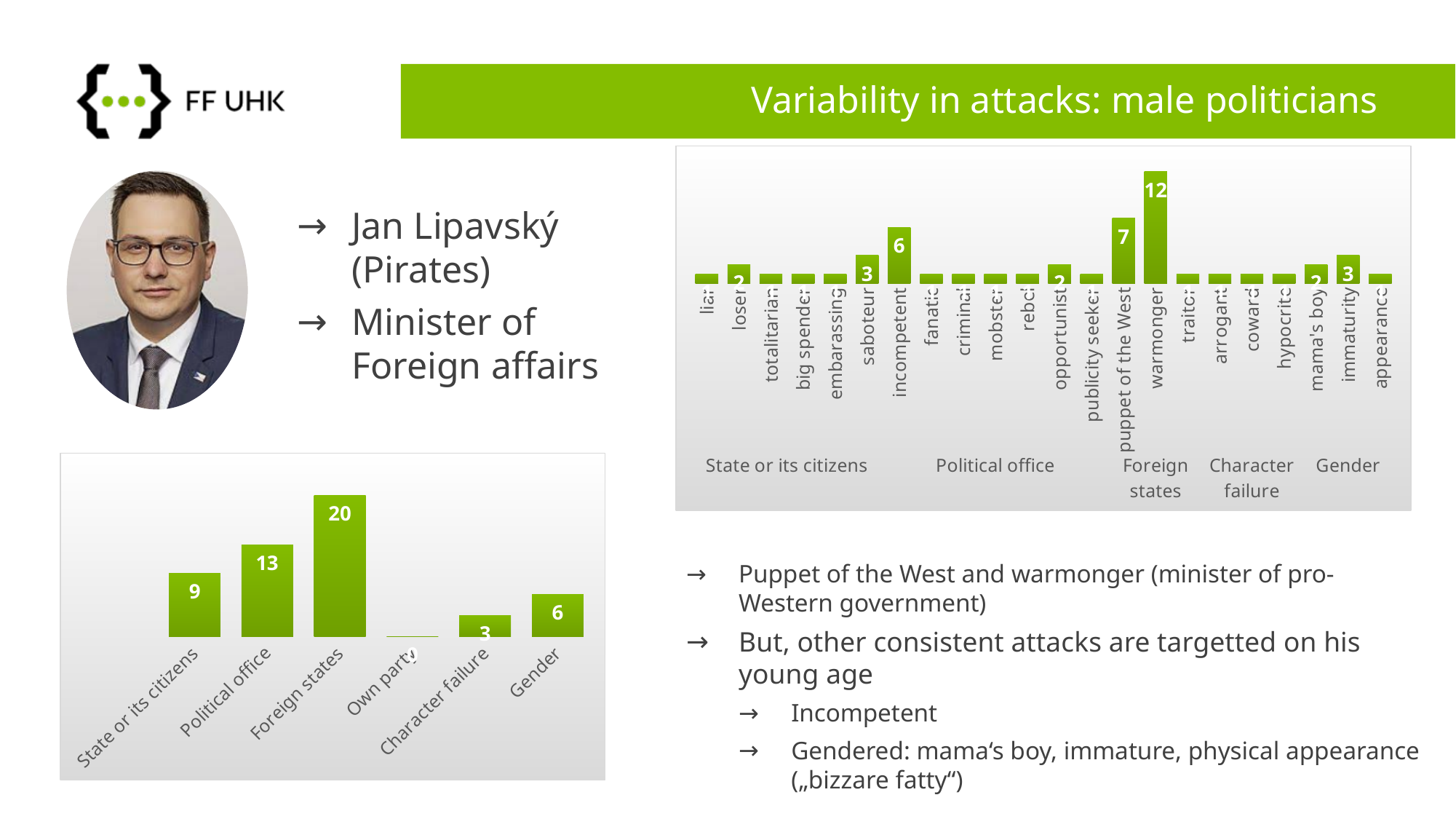
In the bottom-left chart, which is larger: State or its citizens or Gender? State or its citizens How many categories are shown in the bottom-left chart? 6 In the bottom-left chart, what is the value for Political office? 13 In the top-right chart, what is the value for puppet of the West? 7 What kind of chart is the bottom-left chart? bar chart In the bottom-left chart, what is the value for Foreign states? 20 In the top-right chart, what is the difference between incompetent and saboteur? 3 In the top-right chart, which category has the highest value? warmonger In the bottom-left chart, which category has the highest value? Foreign states In the bottom-left chart, which category has the lowest value? Own party In the bottom-left chart, what is the difference between Foreign states and Political office? 7 In the top-right chart, what is the value for warmonger? 12